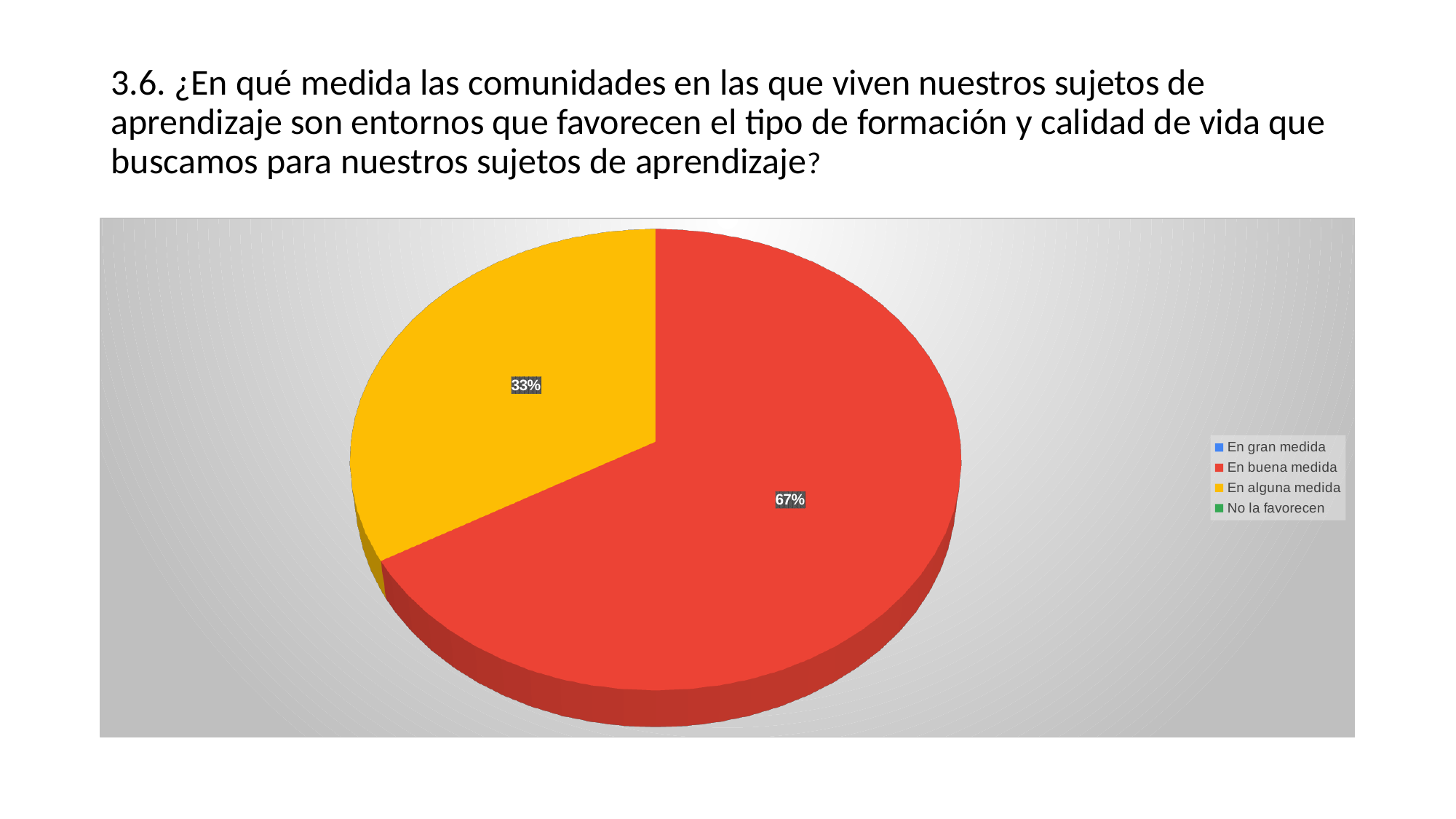
Which category has the largest slice of the pie? En buena medida What colour is the slice for "En alguna medida"? yellow How many slices are visible in the pie? 2 What colour is the slice for "En buena medida"? red How many entries does the legend list? 4 What is the difference in percentage points between the "En buena medida" slice and the "En alguna medida" slice? 34 What share of the pie does "En alguna medida" represent? 33% What kind of chart is shown on the slide? pie chart What share of the pie does "En buena medida" represent? 67% Which is larger, the slice for "En buena medida" or the slice for "En alguna medida"? En buena medida